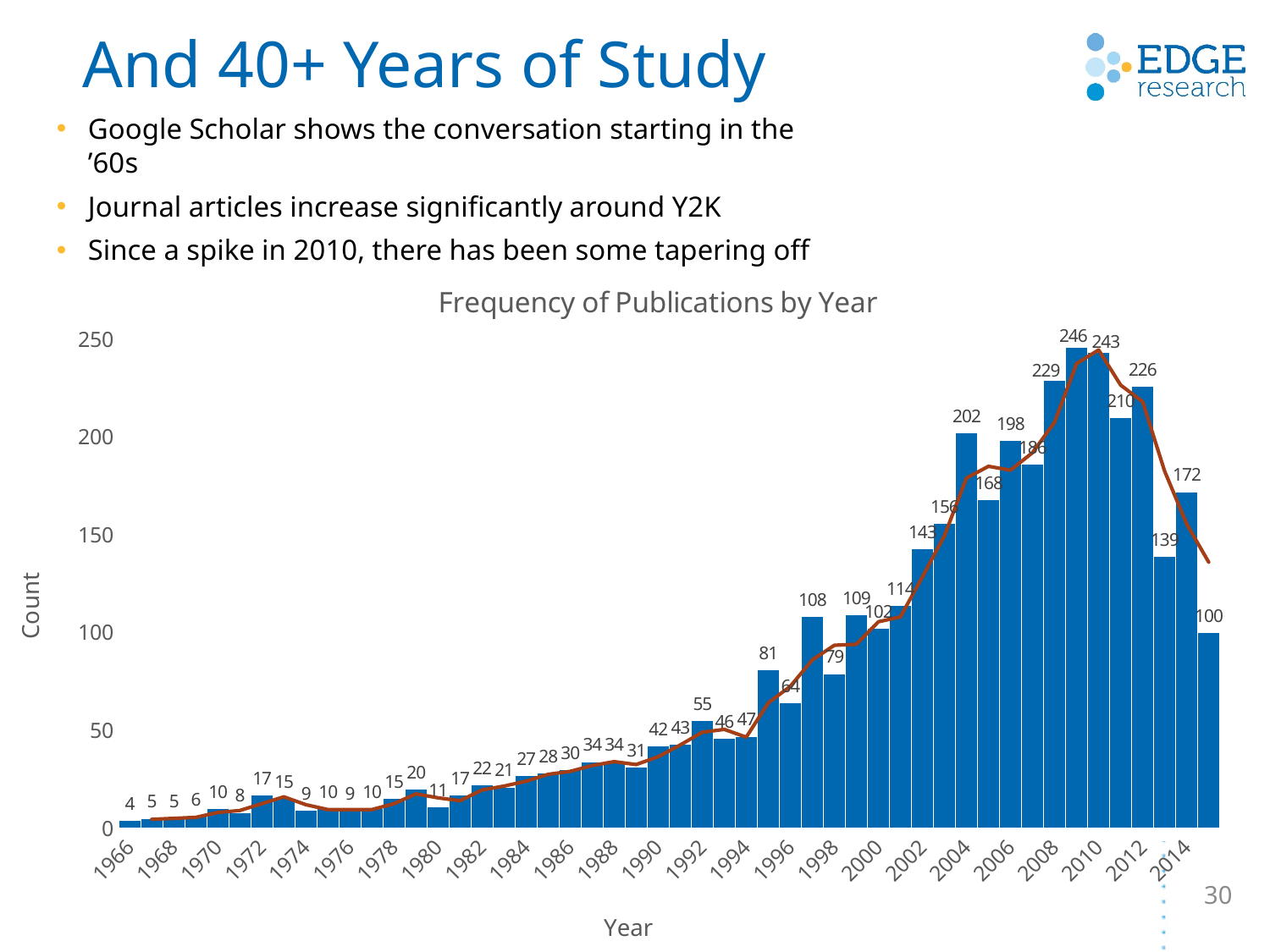
What is the difference between the highest bar value (246) and the last bar value (100)? 146 What kind of chart is shown on the slide? bar chart How many bars (years) are plotted in the chart? 50 What is the lowest value labeled on any bar in the chart? 4 What is the count for the last bar on the chart? 100 What is the label on the vertical axis of the chart? Count What is the title of the chart? Frequency of Publications by Year What is the count for 1966, the first year on the chart? 4 Is the value for the last bar on the chart greater or less than 150? less What is the count for 2014? 172 Which year has the larger count, 1966 or 2014? 2014 What is the highest value labeled on any bar in the chart? 246